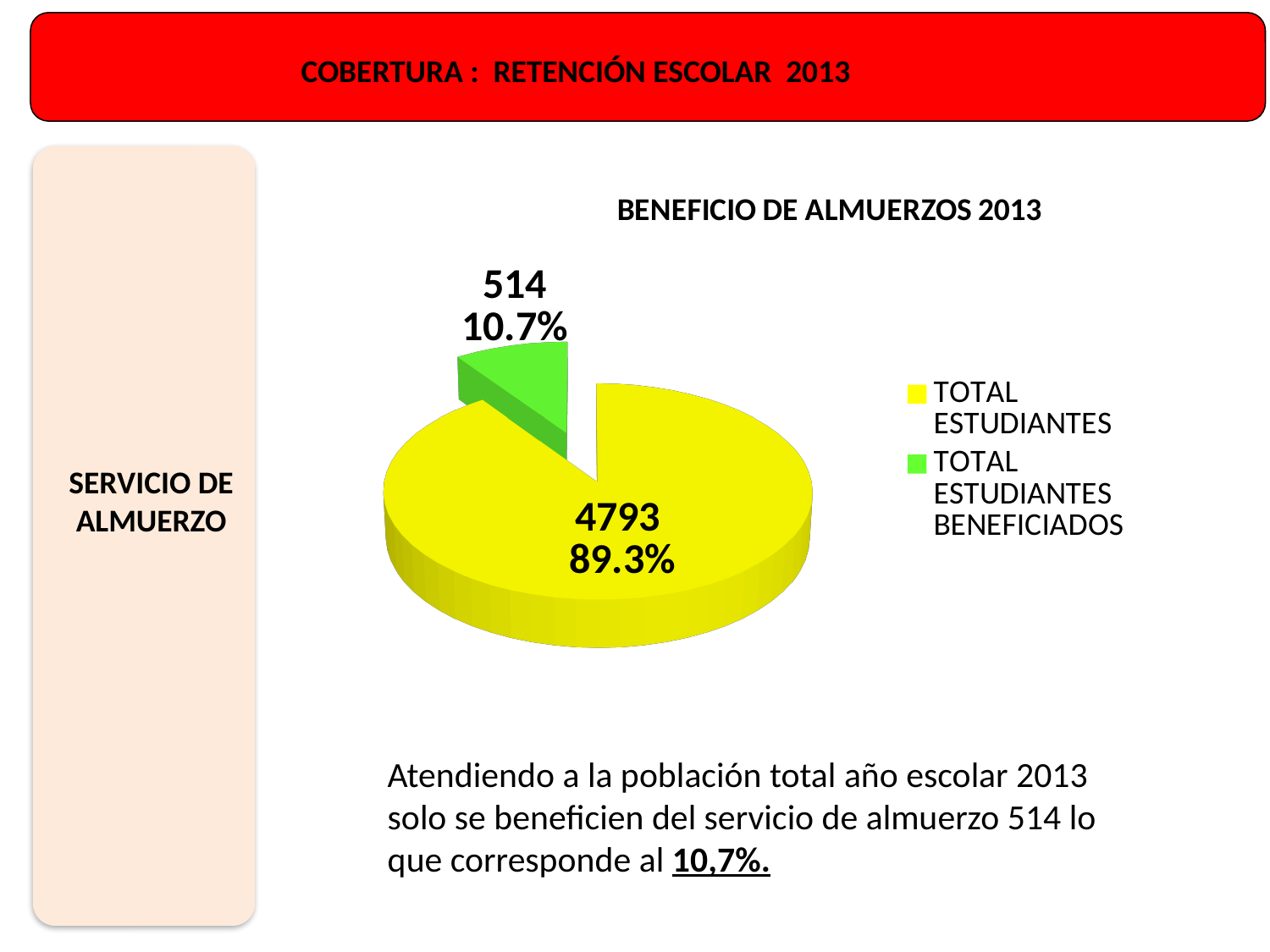
What share of the pie does TOTAL ESTUDIANTES represent? 89.3% What is the value for TOTAL ESTUDIANTES BENEFICIADOS? 514 What share of the pie does TOTAL ESTUDIANTES BENEFICIADOS represent? 10.7% Which is larger, TOTAL ESTUDIANTES or TOTAL ESTUDIANTES BENEFICIADOS? TOTAL ESTUDIANTES Which slice is the smallest? TOTAL ESTUDIANTES BENEFICIADOS What is the difference between the value for TOTAL ESTUDIANTES and the value for TOTAL ESTUDIANTES BENEFICIADOS? 4279 What is the value for TOTAL ESTUDIANTES? 4793 What kind of chart is shown on the slide? pie chart How many slices does the pie chart have? 2 What is the title of the chart? BENEFICIO DE ALMUERZOS 2013 Which slice is the largest? TOTAL ESTUDIANTES What colour is the slice for TOTAL ESTUDIANTES BENEFICIADOS? green